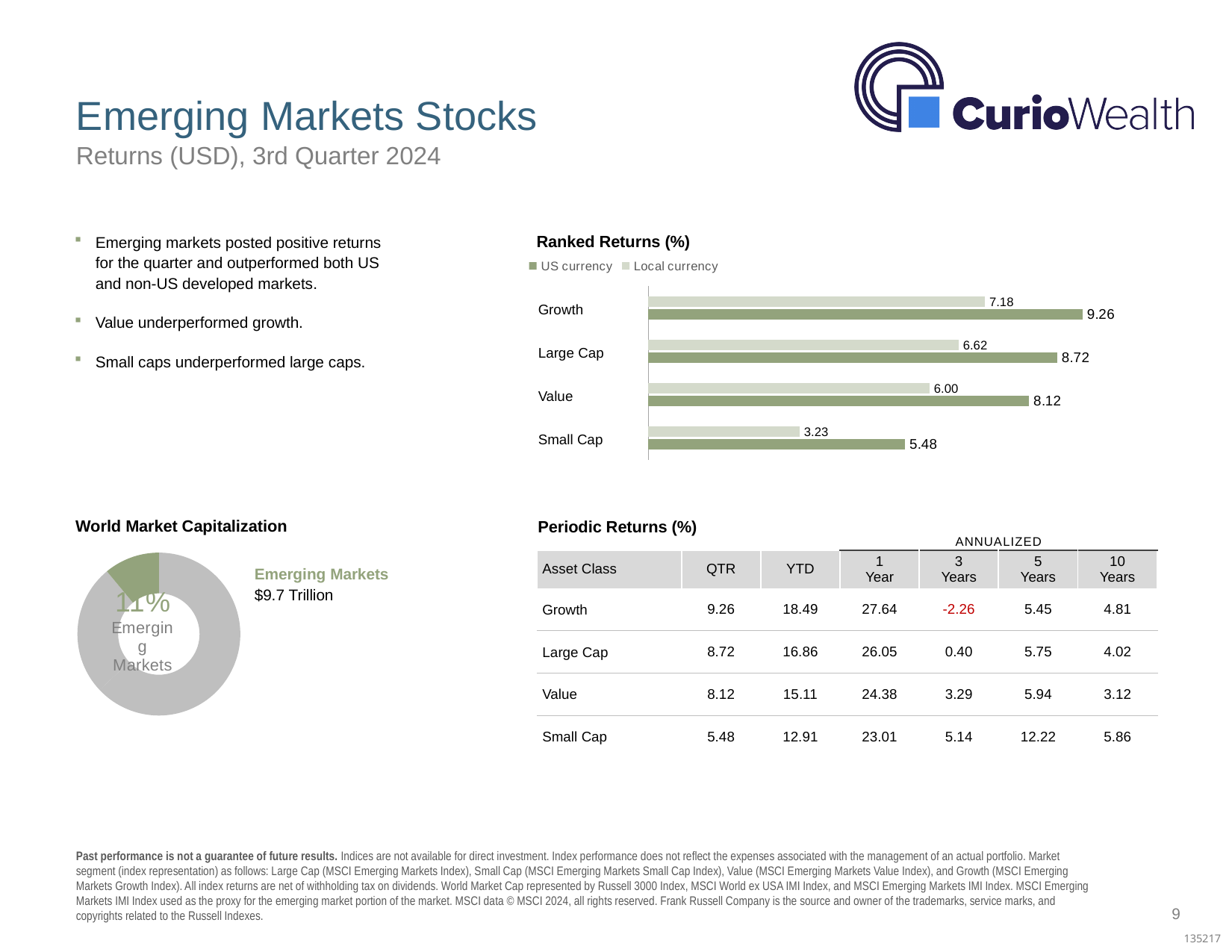
In the Ranked Returns (%) chart, which is larger for Value: the US currency return or the Local currency return? US currency What type of chart is the Ranked Returns (%) chart? Bar chart In the Ranked Returns (%) chart, what is the difference between the US currency and Local currency returns for Large Cap? 2.10 How many series does the legend of the Ranked Returns (%) chart list? 2 In the Ranked Returns (%) chart, what is the US currency return for Growth? 9.26 In the Ranked Returns (%) chart, what is the Local currency return for Small Cap? 3.23 How many categories are shown in the Ranked Returns (%) chart? 4 In the Ranked Returns (%) chart, what is the Local currency return for Value? 6.00 In the Ranked Returns (%) chart, which category has the highest US currency return? Growth In the Ranked Returns (%) chart, which category has the lowest Local currency return? Small Cap In the World Market Capitalization chart, what share of world market capitalization do Emerging Markets represent? 11% What type of chart is the World Market Capitalization chart? Donut chart